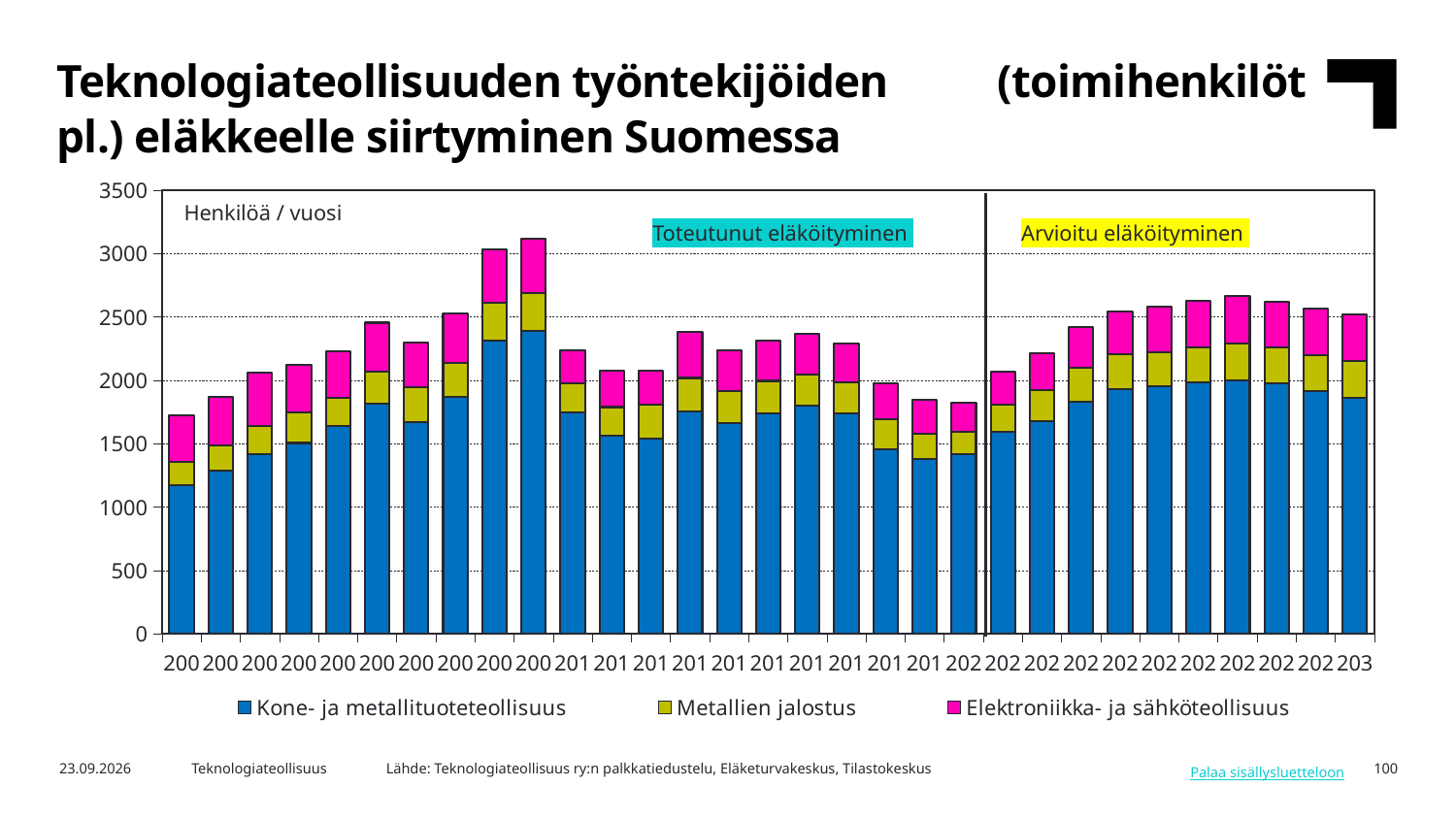
What kind of chart is shown on the slide? Stacked bar chart What unit label is shown at the top left of the plot area? Henkilöä / vuosi Which series is shown in blue in the legend? Kone- ja metallituoteteollisuus Is the total of the shortest stacked bar greater or less than 1500? greater How many bars (years) are plotted in the chart? 31 Is the total of the tallest stacked bar greater or less than 3000? greater How many series does the legend list? 3